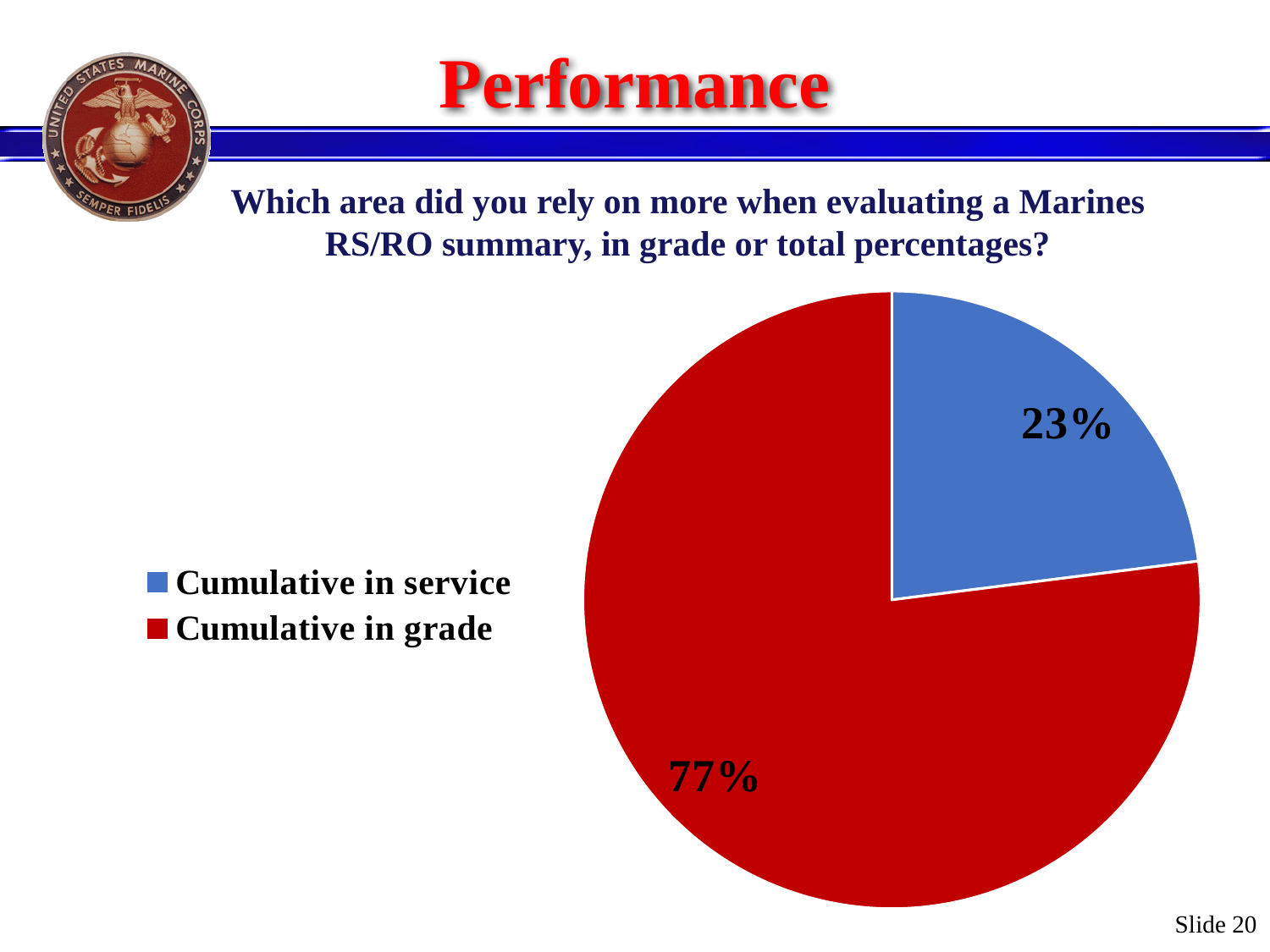
Which category has the smallest share of the pie? Cumulative in service How many slices does the pie chart have? 2 What percentage of the pie is labelled for Cumulative in service? 23% What colour is the slice for Cumulative in grade? red What colour is the slice for Cumulative in service? blue What kind of chart is shown on the slide? pie chart Which is larger, the share for Cumulative in service or the share for Cumulative in grade? Cumulative in grade What is the difference in percentage points between Cumulative in grade and Cumulative in service? 54 What share of the pie does the Cumulative in grade slice represent? 77% What percentage of the pie is labelled for Cumulative in grade? 77% How many entries does the legend list? 2 Which category has the largest share of the pie? Cumulative in grade